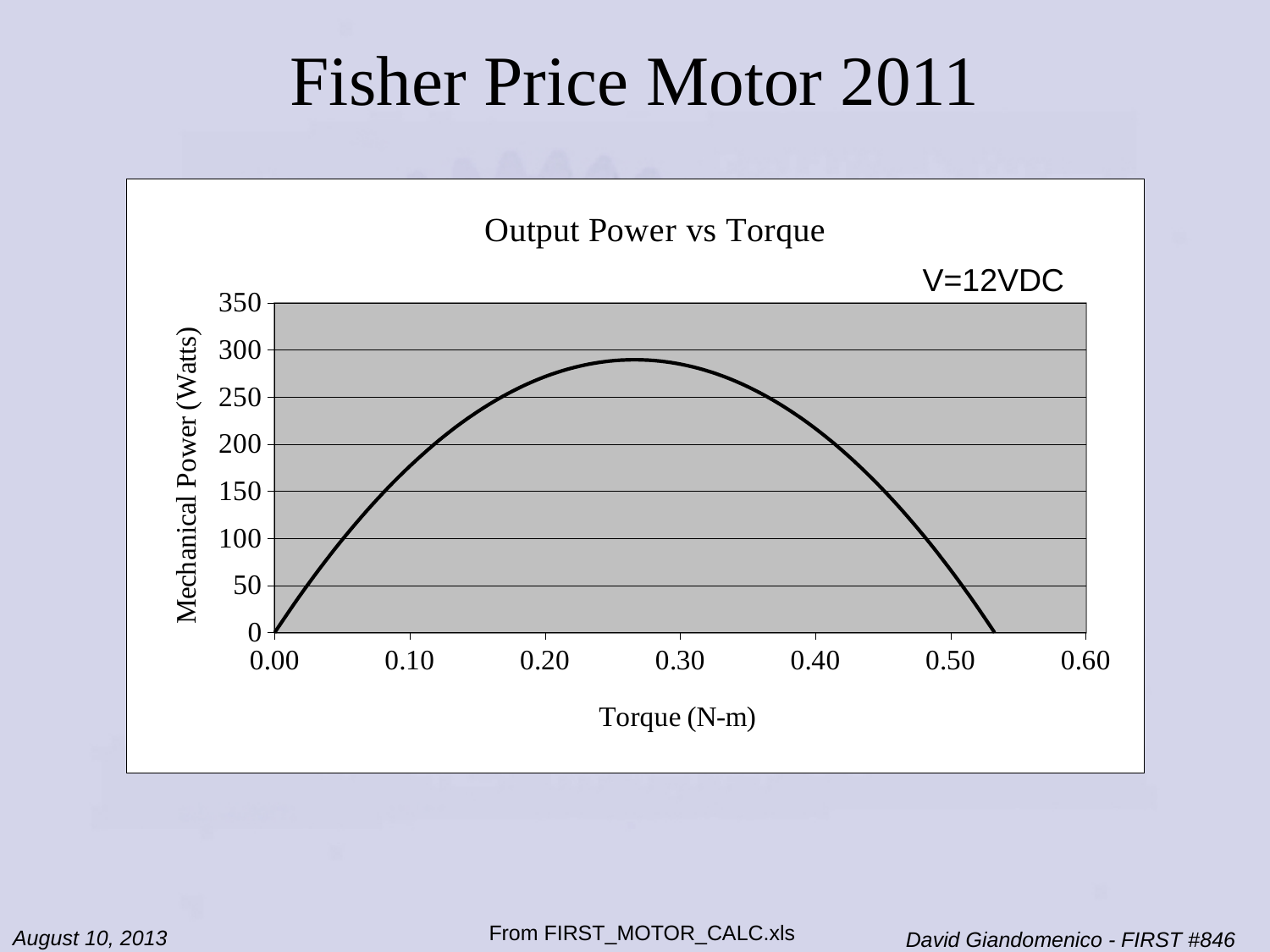
Is the peak mechanical power on the curve greater or less than 300 Watts? less What is the title of the chart? Output Power vs Torque Is the mechanical power at a torque of 0.50 N-m greater or less than 100 Watts? less Does the mechanical power rise or fall as torque increases from 0.40 to 0.50 N-m? fall Is the mechanical power at a torque of 0.20 N-m greater or less than 200 Watts? greater What is the mechanical power at a torque of 0.00 N-m? 0 What kind of chart is shown on the slide? Line chart Does the mechanical power rise or fall as torque increases from 0.00 to 0.20 N-m? rise What is the label of the y axis of the chart? Mechanical Power (Watts)